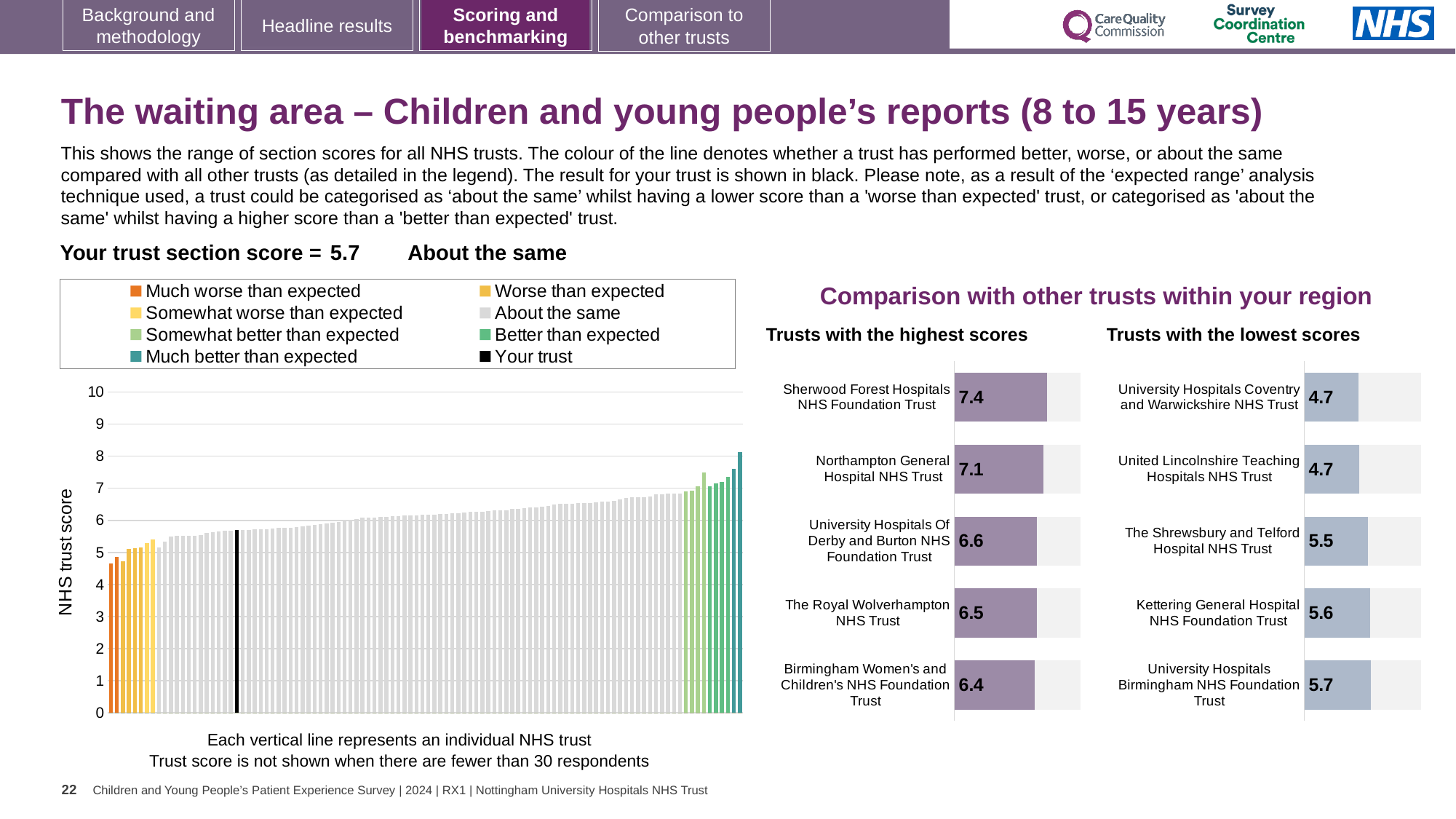
On the 'Trusts with the highest scores' chart, which has the larger score: Northampton General Hospital NHS Trust or University Hospitals Of Derby and Burton NHS Foundation Trust? Northampton General Hospital NHS Trust On the 'Trusts with the highest scores' chart, which trust has the highest score? Sherwood Forest Hospitals NHS Foundation Trust How many entries does the legend of the main NHS trust score chart list? 8 On the 'Trusts with the lowest scores' chart, which trust has the highest score? University Hospitals Birmingham NHS Foundation Trust On the main NHS trust score chart, what is the section score for your trust (the black bar)? 5.7 On the 'Trusts with the lowest scores' chart, what is the score for Kettering General Hospital NHS Foundation Trust? 5.6 On the 'Trusts with the highest scores' chart, what is the score for Northampton General Hospital NHS Trust? 7.1 On the main NHS trust score chart, do the bar values rise or fall from left to right? rise On the 'Trusts with the highest scores' chart, what is the difference between the scores of Sherwood Forest Hospitals NHS Foundation Trust and Birmingham Women's and Children's NHS Foundation Trust? 1.0 On the 'Trusts with the lowest scores' chart, what is the score for The Shrewsbury and Telford Hospital NHS Trust? 5.5 How many trusts are shown on the 'Trusts with the lowest scores' chart? 5 On the 'Trusts with the highest scores' chart, what is the score for Sherwood Forest Hospitals NHS Foundation Trust? 7.4